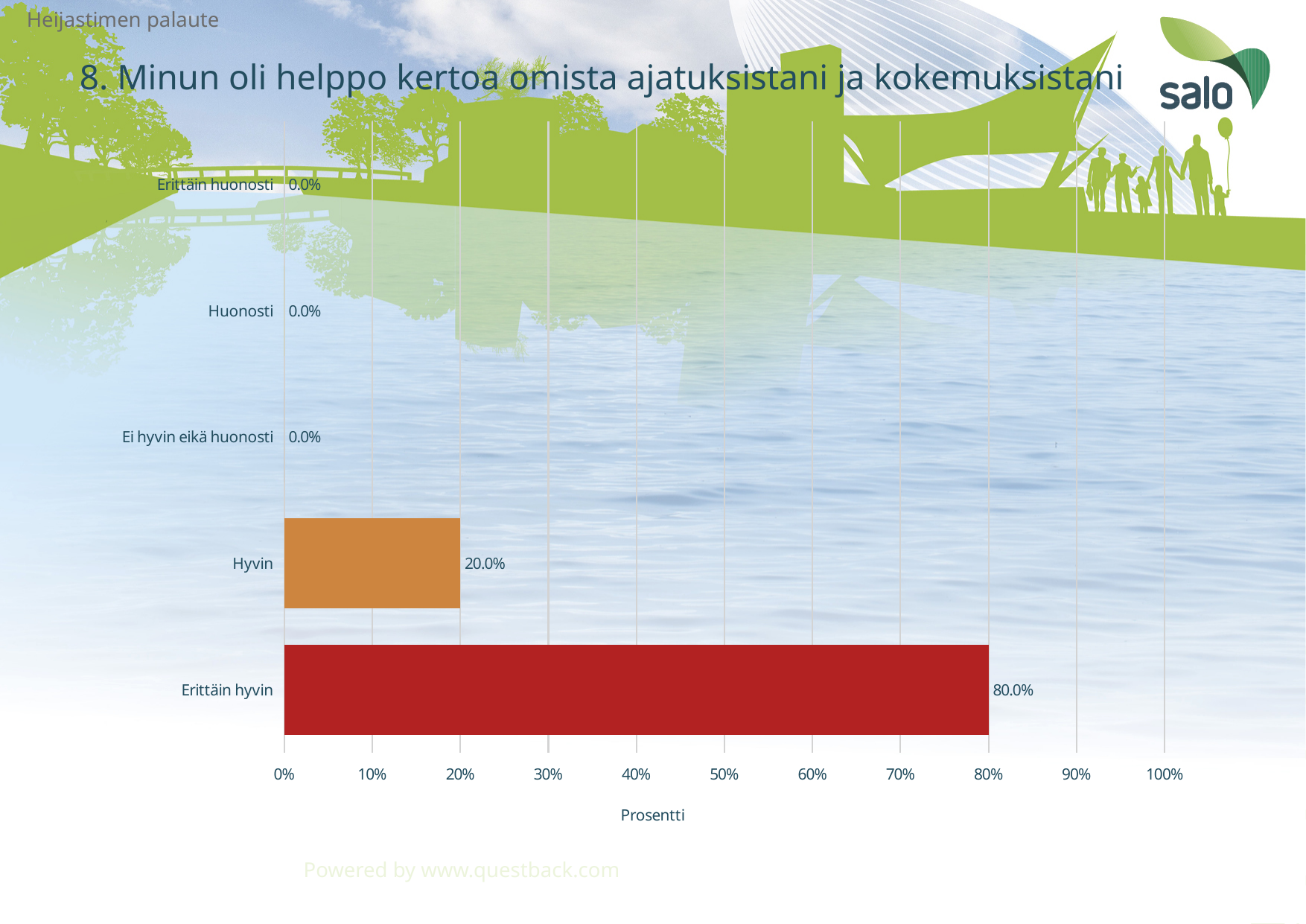
What is the value for Ei hyvin eikä huonosti? 0.0% Which is larger, the value for Hyvin or the value for Erittäin hyvin? Erittäin hyvin Which category has the highest value? Erittäin hyvin What is the difference between the values for Erittäin hyvin and Hyvin? 60.0% What kind of chart is shown on the slide? bar chart How many categories are shown on the chart? 5 What is the value for Huonosti? 0.0% What is the title of the chart? 8. Minun oli helppo kertoa omista ajatuksistani ja kokemuksistani What is the value for Erittäin hyvin? 80.0% What is the label of the horizontal axis? Prosentti What is the value for Hyvin? 20.0% Is the value for Erittäin hyvin greater or less than 50%? greater